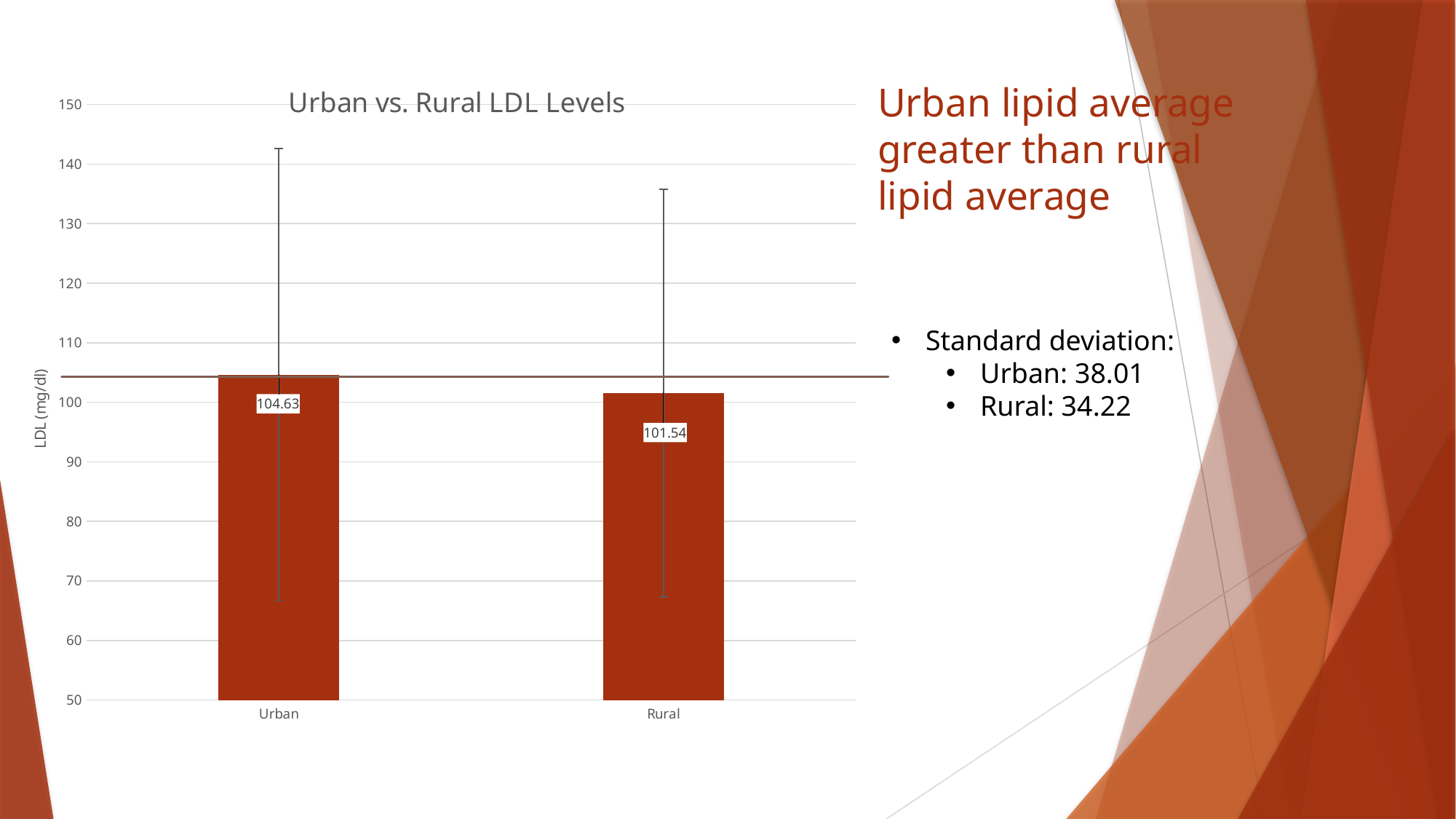
What kind of chart is shown on the slide? bar chart Which category has the higher LDL level? Urban What is the title of the chart? Urban vs. Rural LDL Levels What is the difference between the Urban and Rural LDL values? 3.09 Is the LDL value for Rural greater or less than 110? less Is the Urban LDL value larger or smaller than the Rural LDL value? larger Is the LDL value for Urban greater or less than 100? greater What is the LDL value for Rural? 101.54 What is the label of the vertical axis? LDL (mg/dl) Which category has the lower LDL level? Rural How many categories are shown on the x axis? 2 What is the LDL value for Urban? 104.63